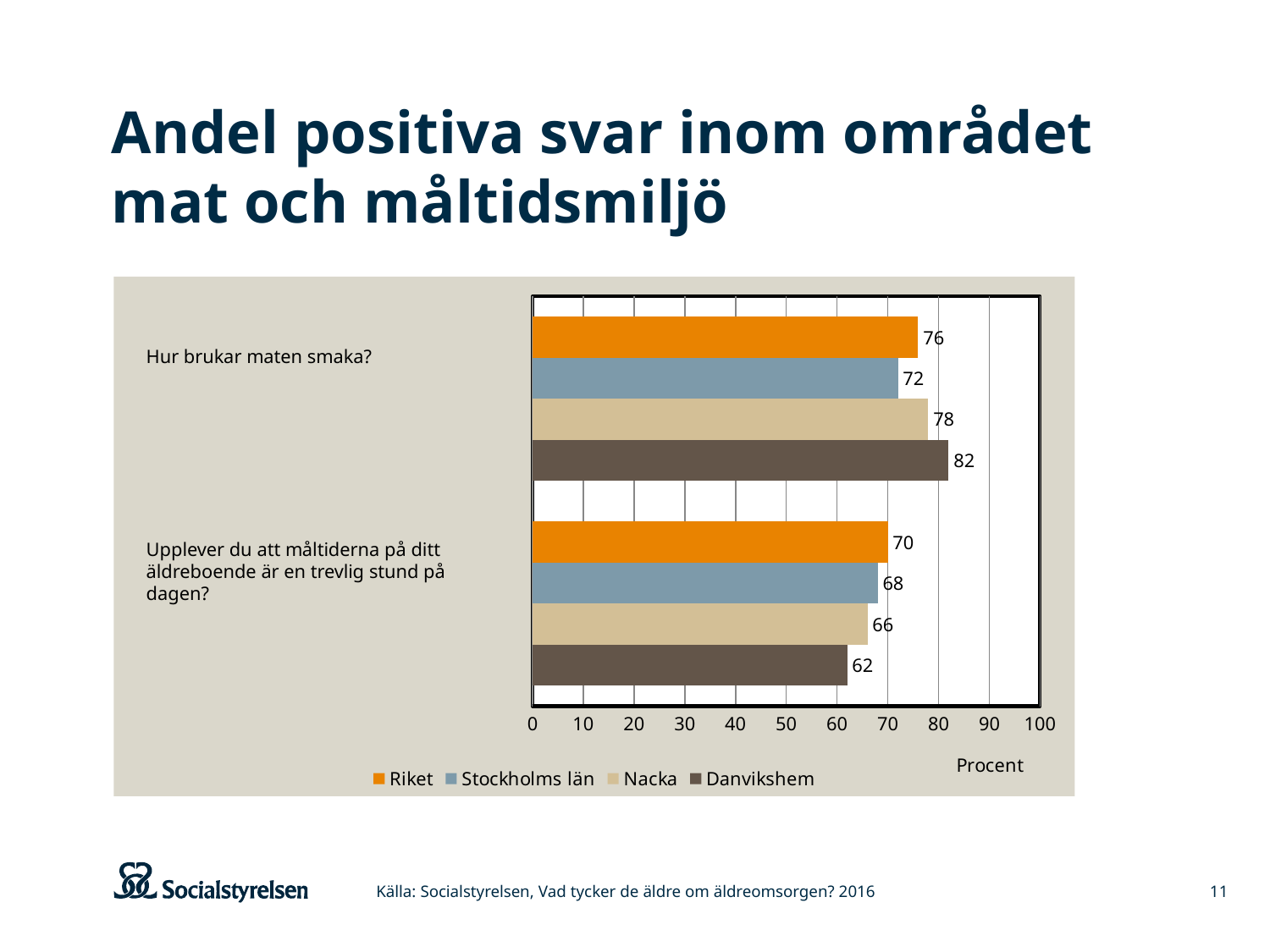
How many questions (categories) are shown on the chart? 2 How many series does the legend list? 4 What is the difference between the Danvikshem values for the two questions? 20 What is the value for Danvikshem on the question "Hur brukar maten smaka?" 82 What is the label of the horizontal axis? Procent Which is larger for "Hur brukar maten smaka?": Nacka or Riket? Nacka Which series has the lowest value for "Upplever du att måltiderna på ditt äldreboende är en trevlig stund på dagen?" Danvikshem What is the value for Stockholms län on the question "Hur brukar maten smaka?" 72 Which series has the highest value for "Hur brukar maten smaka?" Danvikshem What is the difference between Nacka and Stockholms län for "Upplever du att måltiderna på ditt äldreboende är en trevlig stund på dagen?" 2 What is the value for Riket on the question "Upplever du att måltiderna på ditt äldreboende är en trevlig stund på dagen?" 70 What kind of chart is shown on the slide? Bar chart